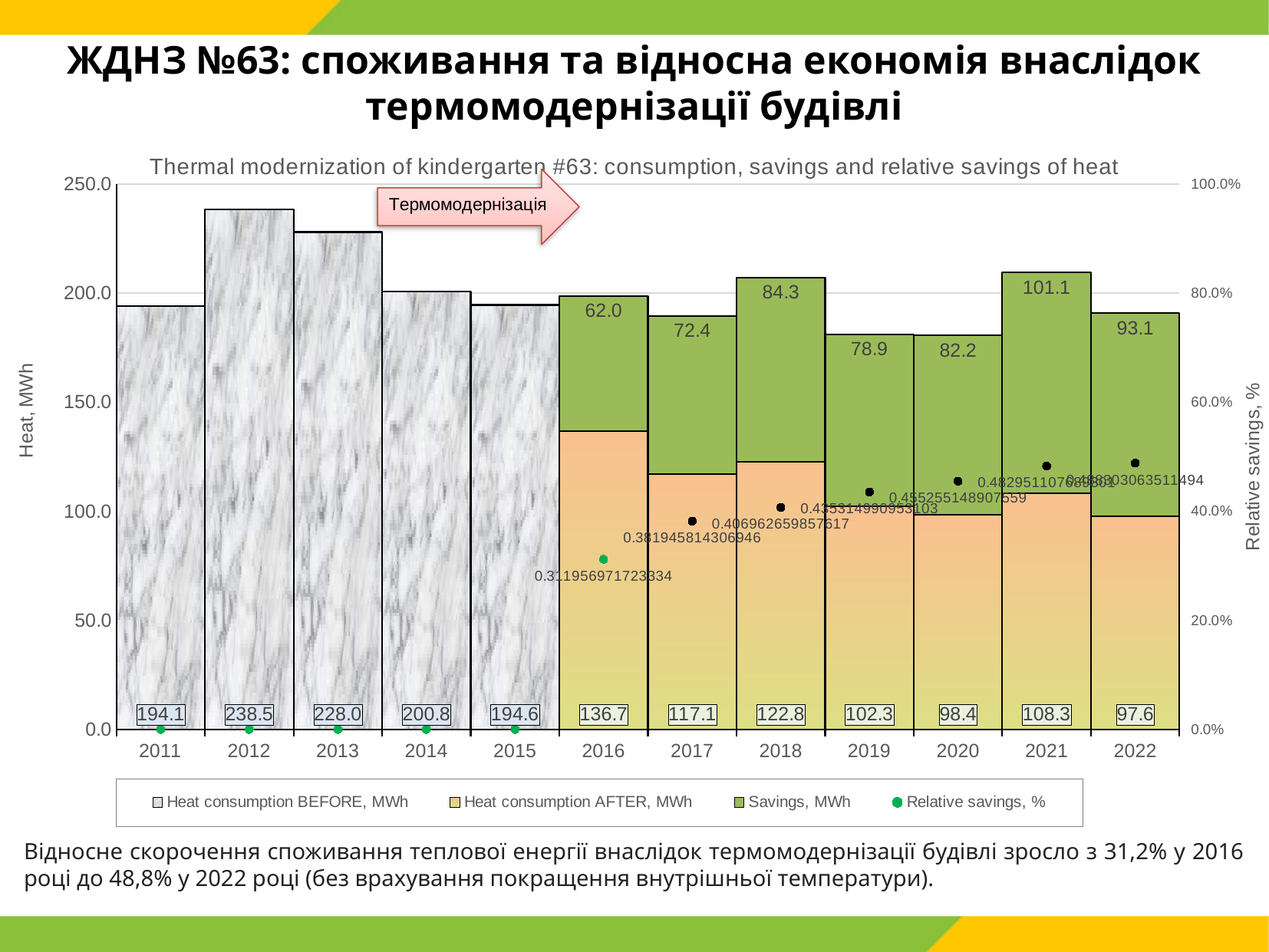
Is the total height of the stacked bar for 2016 greater or less than 150.0? greater Which year has the highest Savings, MWh value? 2021 What kind of chart is this? combination stacked bar and line chart Which year has the lowest Heat consumption AFTER value? 2022 What is the Heat consumption BEFORE value for 2012? 238.5 Which is larger: the Savings value for 2017 or for 2020? 2020 How many series does the legend list? 4 What is the difference between the Heat consumption BEFORE values for 2012 and 2011? 44.4 What is the Savings, MWh value for 2018? 84.3 What is the total of the stacked bar for 2021 (Heat consumption AFTER plus Savings)? 209.4 What is the Heat consumption AFTER value for 2019? 102.3 How many years are shown on the x axis? 12